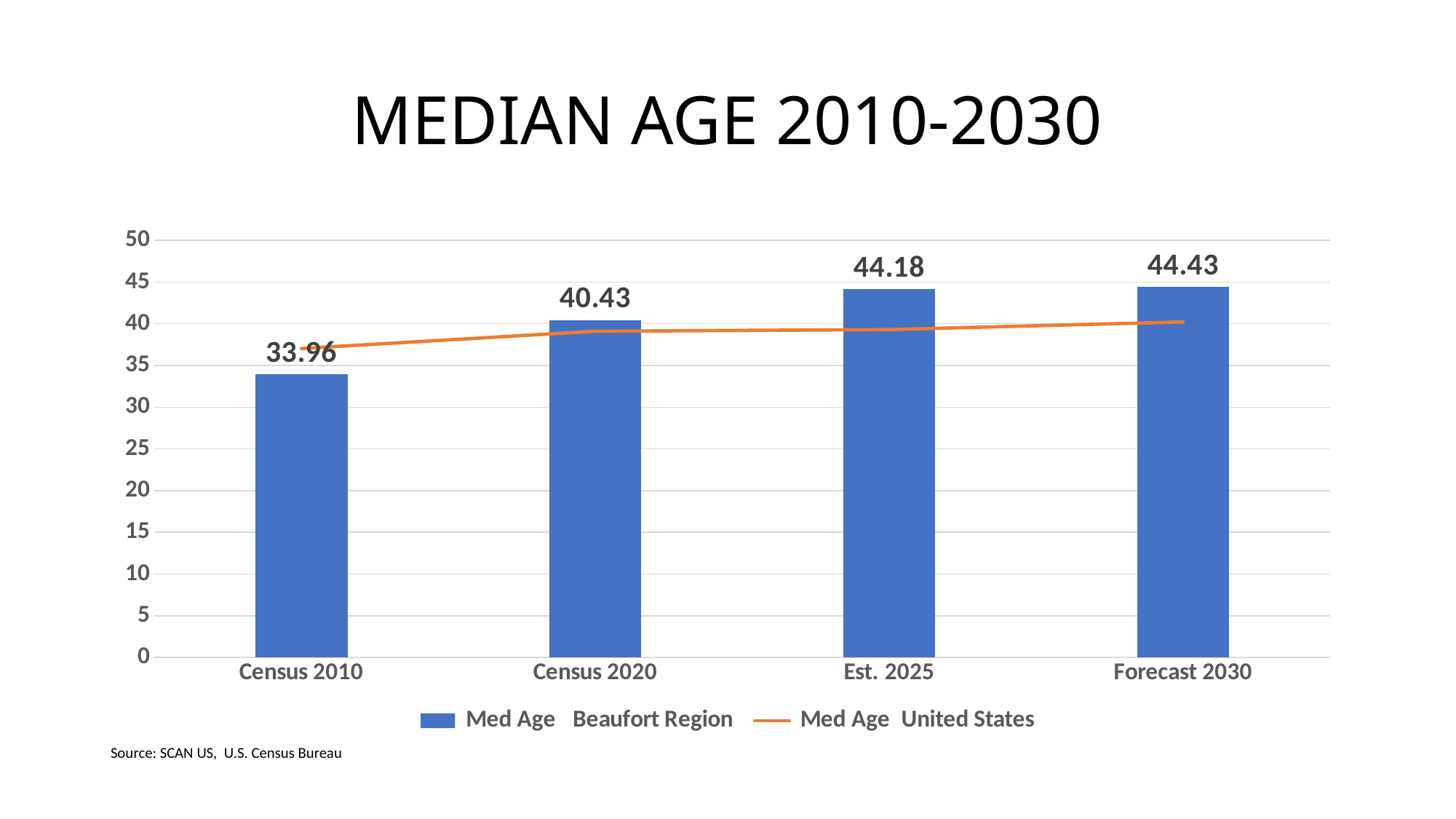
Is the United States median age in Forecast 2030 greater or less than 45? less What is the median age for the Beaufort Region in Forecast 2030? 44.43 Is the Beaufort Region median age higher in Census 2020 or in Est. 2025? Est. 2025 What is the median age for the Beaufort Region in Census 2020? 40.43 What is the median age for the Beaufort Region in Est. 2025? 44.18 Does the Beaufort Region median age rise or fall from Census 2010 to Forecast 2030? rise Which period has the lowest Beaufort Region median age? Census 2010 How many periods are shown on the x axis? 4 What is the difference between the Beaufort Region median age in Census 2020 and Census 2010? 6.47 Which period has the highest Beaufort Region median age? Forecast 2030 How many series does the legend list? 2 What is the median age for the Beaufort Region in Census 2010? 33.96